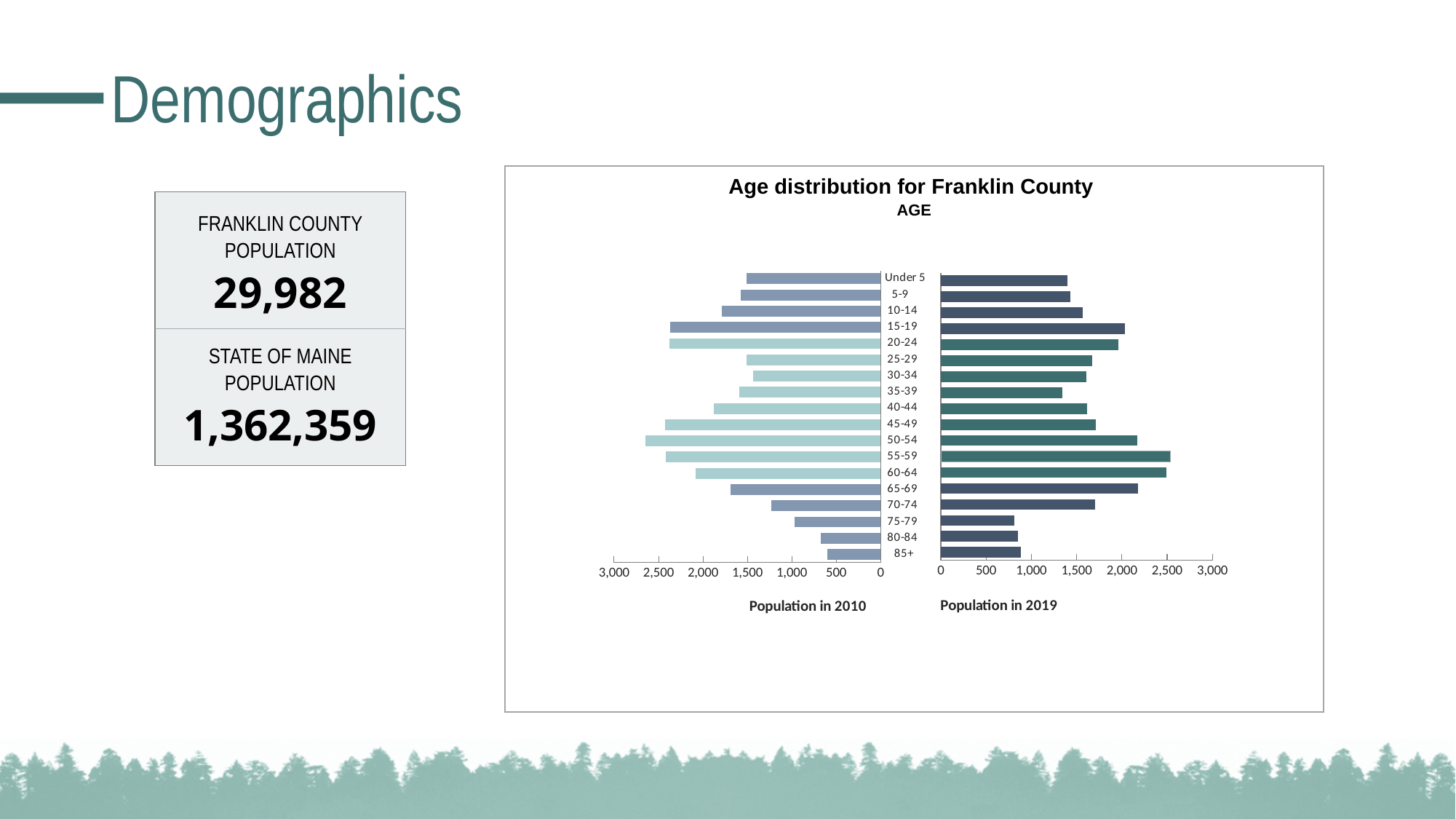
What does the left side of the 'Age distribution for Franklin County' chart represent? Population in 2010 How many age groups are shown in the 'Age distribution for Franklin County' chart? 18 How many population series does the 'Age distribution for Franklin County' chart show? 2 In the 'Age distribution for Franklin County' chart, is the population in 2019 for the 75-79 age group greater or less than 1,000? less In the 'Age distribution for Franklin County' chart, which age group has the lowest population in 2010? 85+ In the 'Age distribution for Franklin County' chart, was the population of the 50-54 age group larger in 2010 or in 2019? 2010 What kind of chart is the 'Age distribution for Franklin County' chart? bar chart In the 'Age distribution for Franklin County' chart, which age group has the highest population in 2010? 50-54 In the 'Age distribution for Franklin County' chart, is the population in 2010 for the 85+ age group greater or less than 1,000? less In the 'Age distribution for Franklin County' chart, was the population of the 85+ age group larger in 2010 or in 2019? 2019 In the 'Age distribution for Franklin County' chart, is the population in 2010 for the 15-19 age group greater or less than 2,000? greater